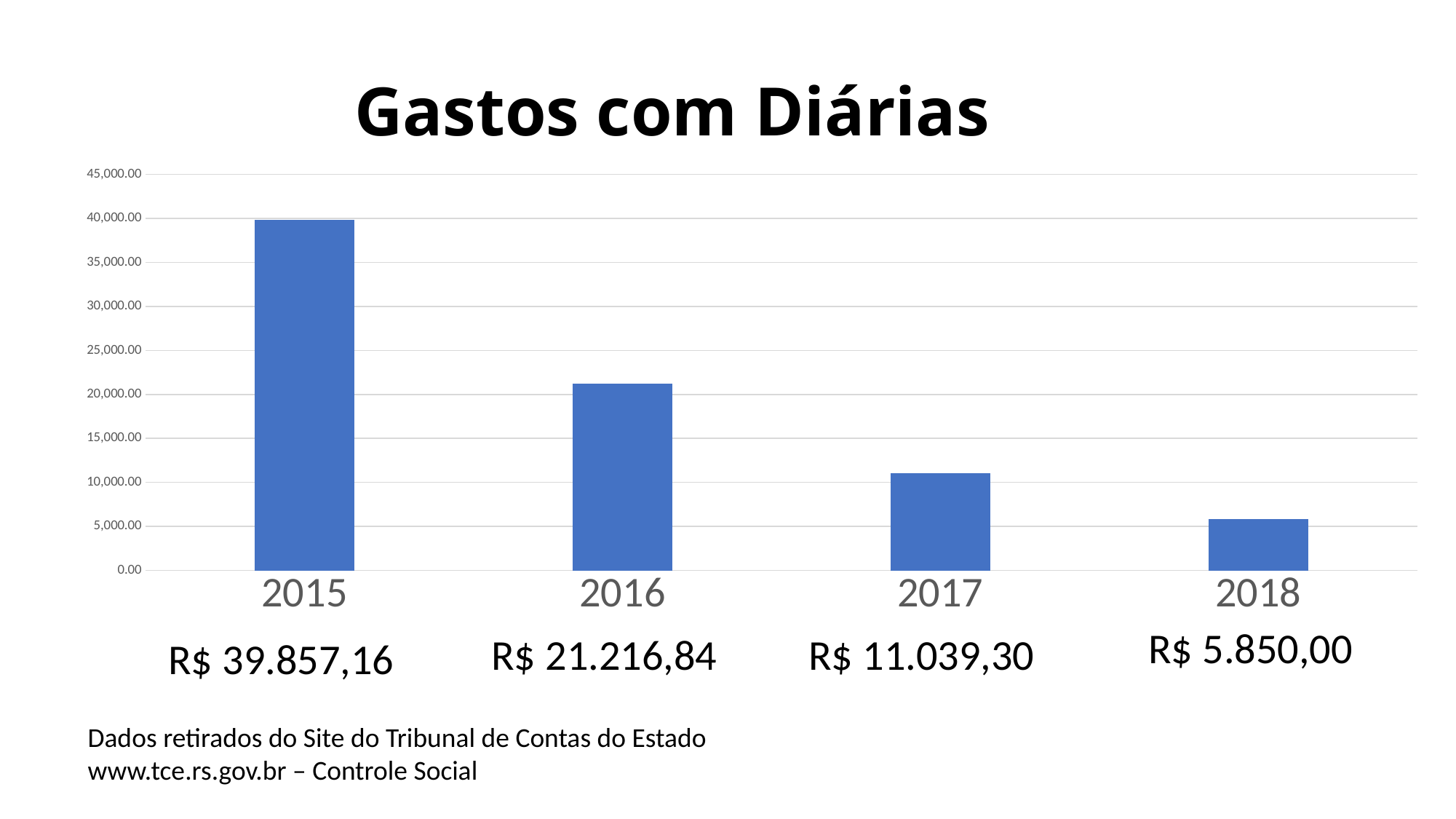
What is the difference between the values for 2017 and 2018? R$ 5.189,30 What is the difference between the values for 2015 and 2016? R$ 18.640,32 How many years are shown on the x axis? 4 What is the value shown for 2018? R$ 5.850,00 Which year has the highest spending? 2015 Which year has the lowest spending? 2018 What is the value shown for 2015? R$ 39.857,16 Is the value for 2017 greater or less than 15,000.00? less What is the value shown for 2017? R$ 11.039,30 Which is larger, the value for 2016 or the value for 2017? 2016 Do the values rise or fall from 2015 to 2018? fall What is the value shown for 2016? R$ 21.216,84